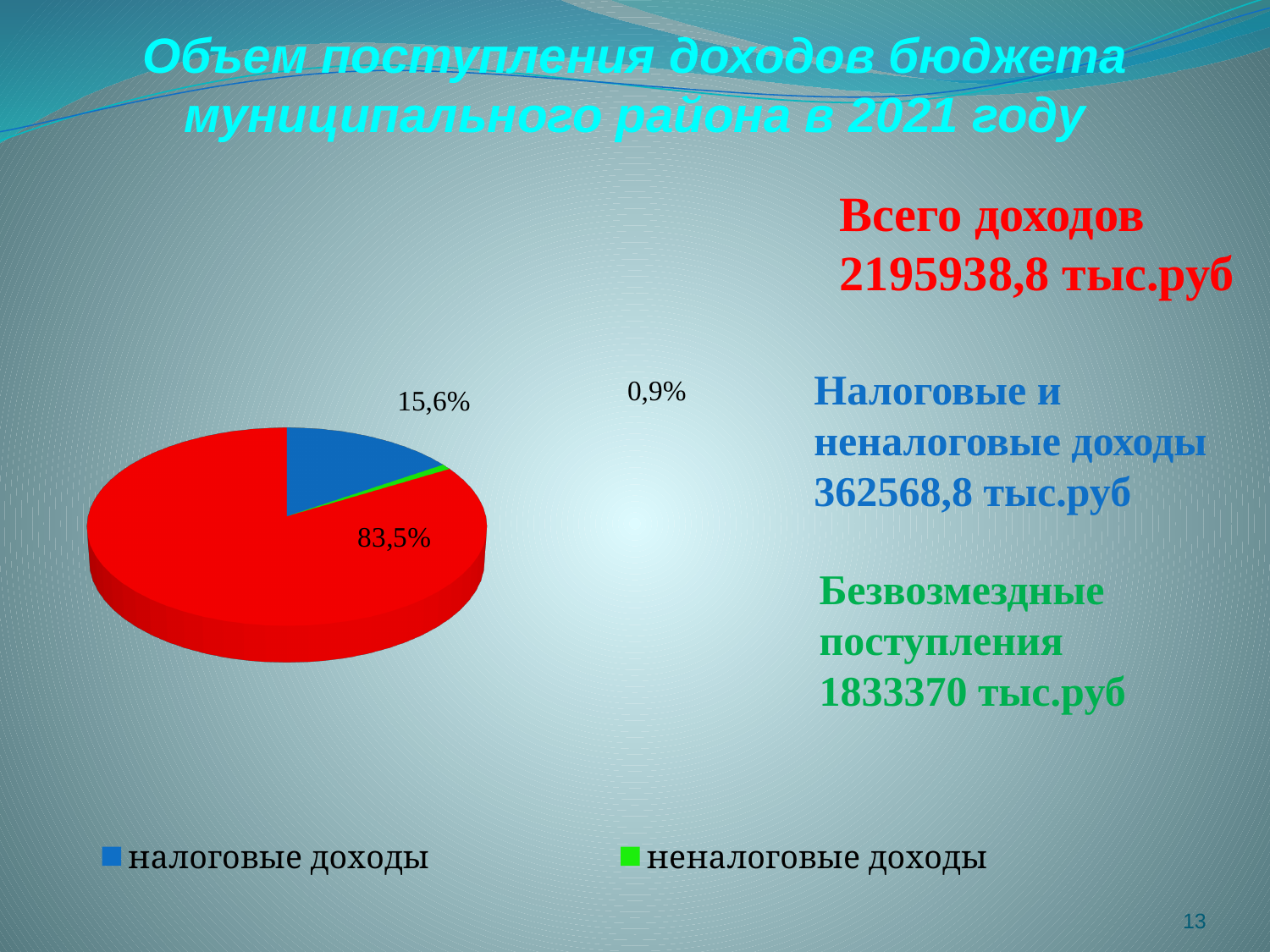
How many slices does the pie chart have? 3 How many entries does the legend list? 2 What kind of chart is shown on the slide? pie chart What share of the pie does "неналоговые доходы" represent? 0,9% What is the title of the slide containing the pie chart? Объем поступления доходов бюджета муниципального района в 2021 году What is the difference in percentage points between the largest (red) slice and the "налоговые доходы" slice? 67,9% What colour is the slice for "налоговые доходы"? blue What share of the pie does "налоговые доходы" represent? 15,6% Which legend category has the smallest slice of the pie? неналоговые доходы What percentage is shown on the largest (red) slice of the pie? 83,5% Which is larger, the slice for "налоговые доходы" or the slice for "неналоговые доходы"? налоговые доходы What is the difference in percentage points between the "налоговые доходы" slice and the "неналоговые доходы" slice? 14,7%